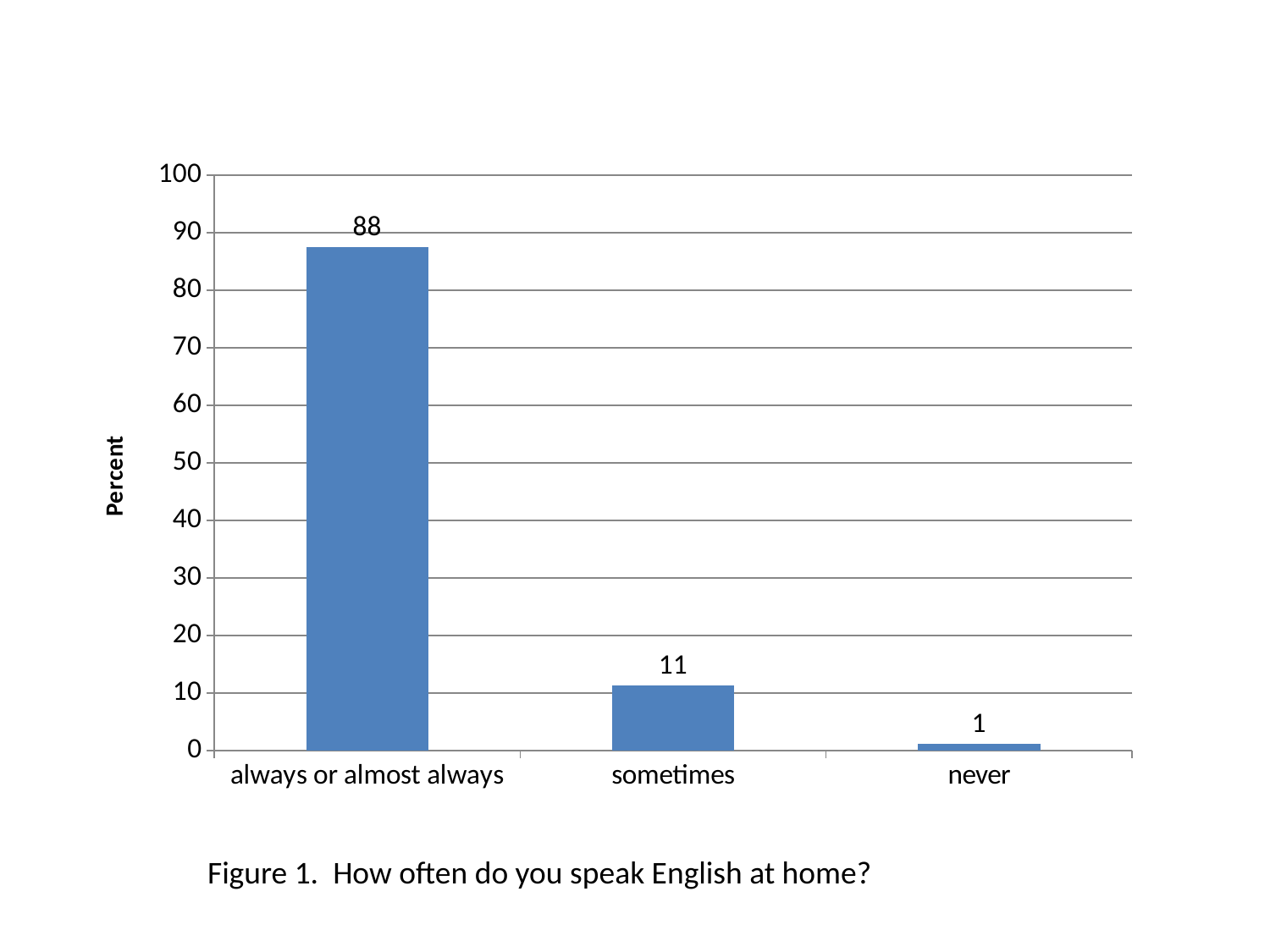
How many categories are shown on the x axis? 3 What is the value for "sometimes"? 11 Which category has the highest value? always or almost always What is the difference between the values for "sometimes" and "never"? 10 Which is larger, the value for "sometimes" or the value for "never"? sometimes What kind of chart is shown on the slide? bar chart What is the label of the y axis? Percent What is the value for "always or almost always"? 88 Which category has the lowest value? never Is the value for "always or almost always" greater or less than 80? greater What is the difference between the values for "always or almost always" and "sometimes"? 77 What is the value for "never"? 1